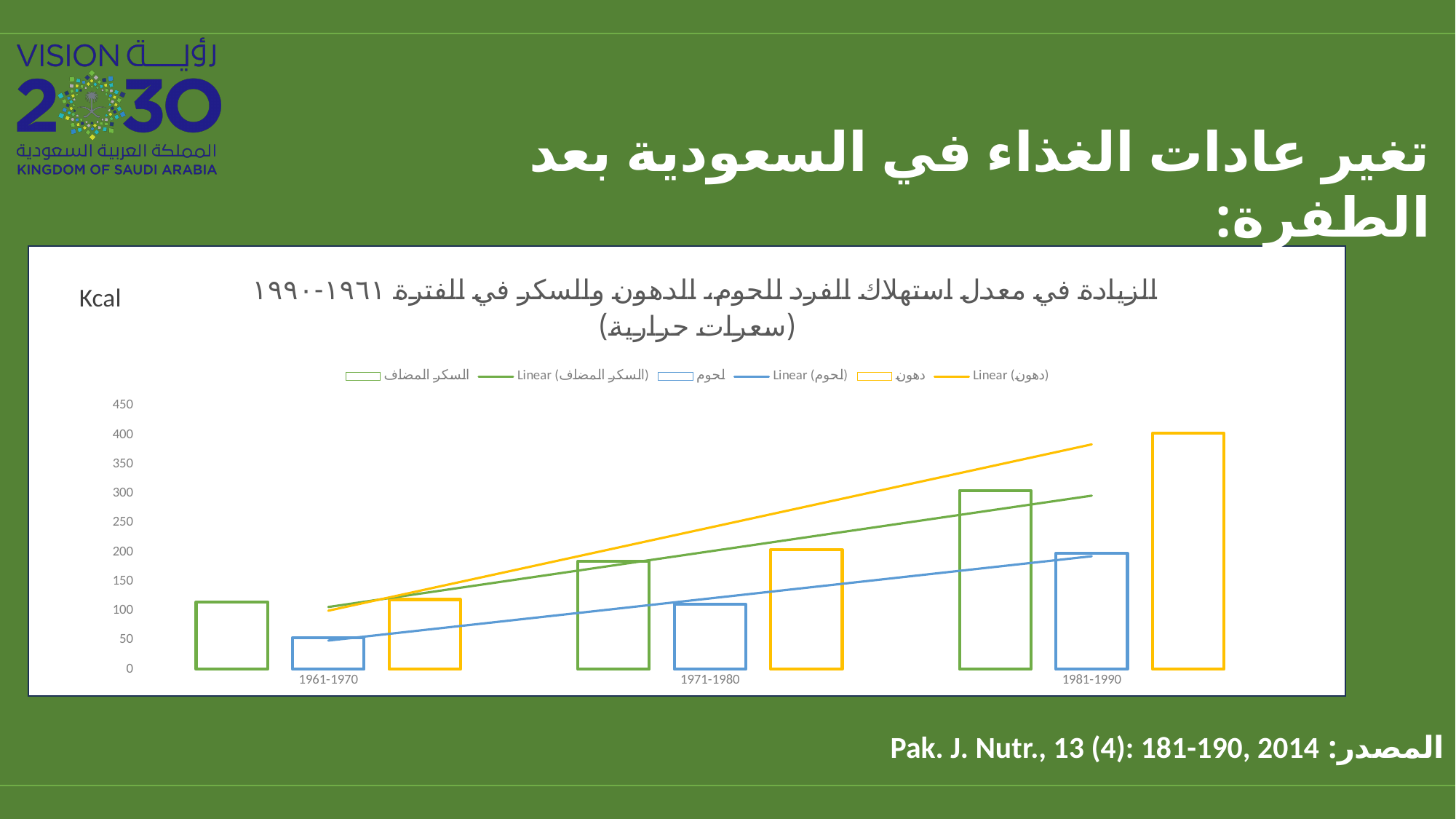
Which bar is the lowest in the whole chart? لحوم in 1961-1970 What kind of chart is shown on the slide? Bar chart (with linear trendlines) Do the values for each series rise or fall from 1961-1970 to 1981-1990? rise Which series has the highest bar in 1981-1990? دهون How many entries does the chart's legend list? 6 How many time periods are shown on the x axis of the chart? 3 Is the value for السكر المضاف in 1971-1980 greater or less than 200? less In 1971-1980, which is larger: السكر المضاف or لحوم? السكر المضاف